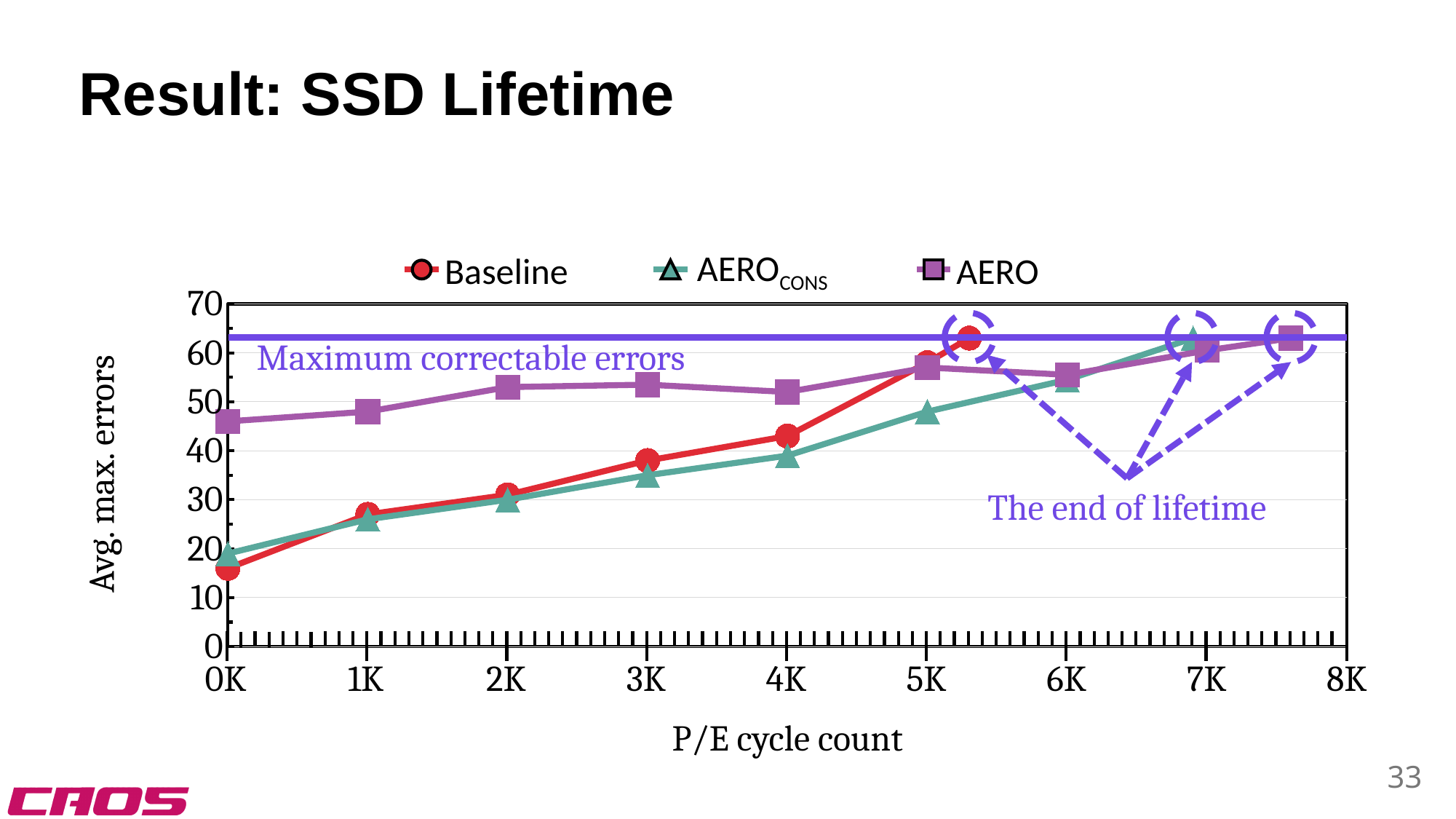
Do the Baseline values rise or fall as the P/E cycle count increases? rise Is the value for Baseline at 3K P/E cycles greater or less than 40? less How many series does the legend list? 3 Is the value for AERO at 3K P/E cycles greater or less than 50? greater Is the value for Baseline at 4K P/E cycles greater or less than 40? greater What is the title of the x axis? P/E cycle count What kind of chart is shown on the slide? line chart What does the horizontal purple line across the chart represent? Maximum correctable errors At 0K P/E cycles, which series has the larger value, AERO or Baseline? AERO At 2K P/E cycles, which series has the larger value, AERO or AERO_CONS? AERO